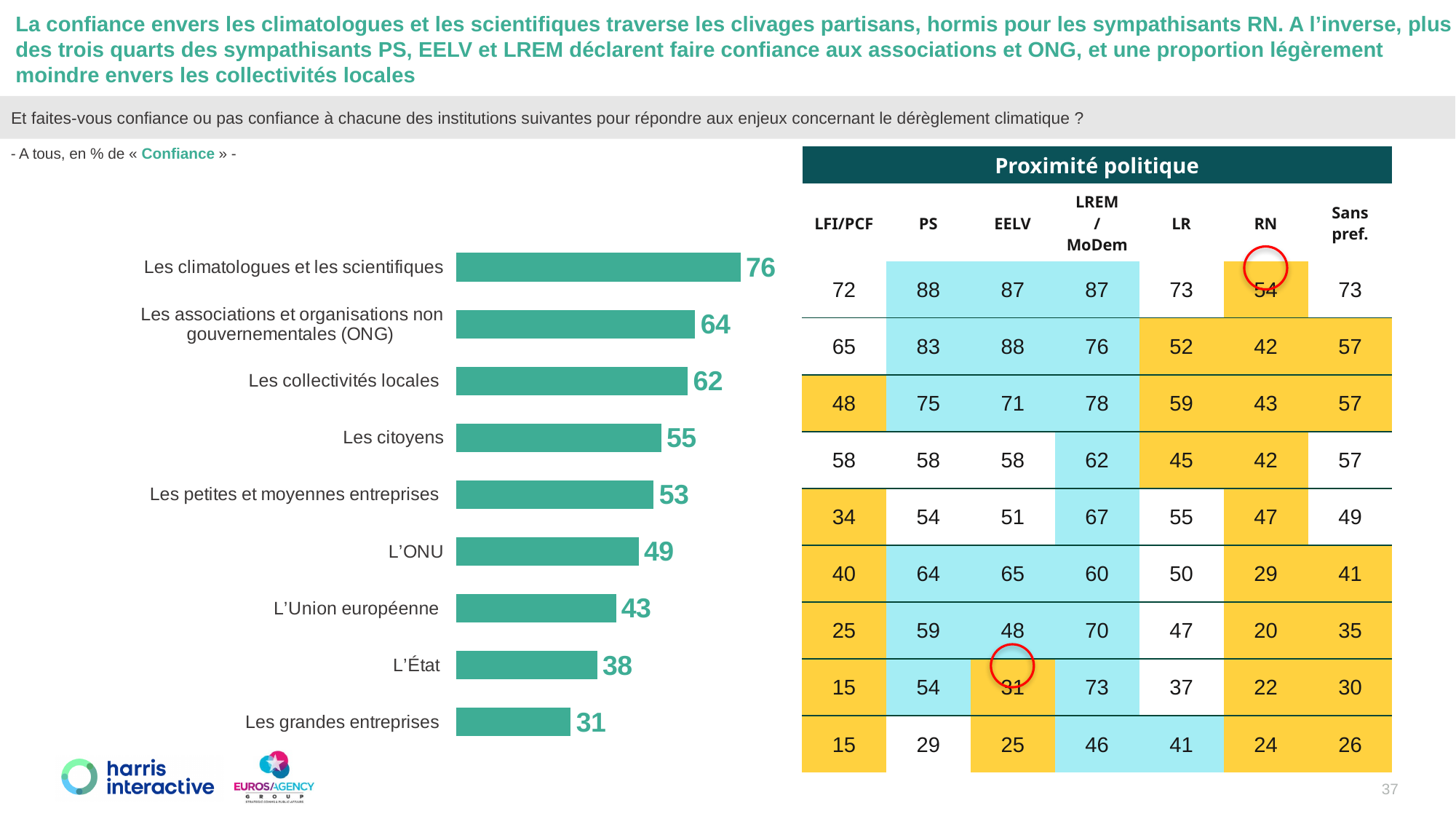
How many categories are shown in the bar chart? 9 Which category has the lowest value in the bar chart? Les grandes entreprises Which category has the highest value in the bar chart? Les climatologues et les scientifiques What is the difference between the values for « Les associations et organisations non gouvernementales (ONG) » and « Les collectivités locales »? 2 What value is shown for « L'ONU » in the bar chart? 49 What value is shown for « L'État » in the bar chart? 38 Which has a larger value in the bar chart, « Les citoyens » or « L'Union européenne »? Les citoyens What kind of chart is shown on the left of the slide? Bar chart Which has a larger value in the bar chart, « L'ONU » or « Les petites et moyennes entreprises »? Les petites et moyennes entreprises What is the difference between the values for « Les climatologues et les scientifiques » and « Les grandes entreprises »? 45 Do the values in the bar chart increase or decrease from the top category to the bottom category? Decrease What value is shown for « Les climatologues et les scientifiques » in the bar chart? 76